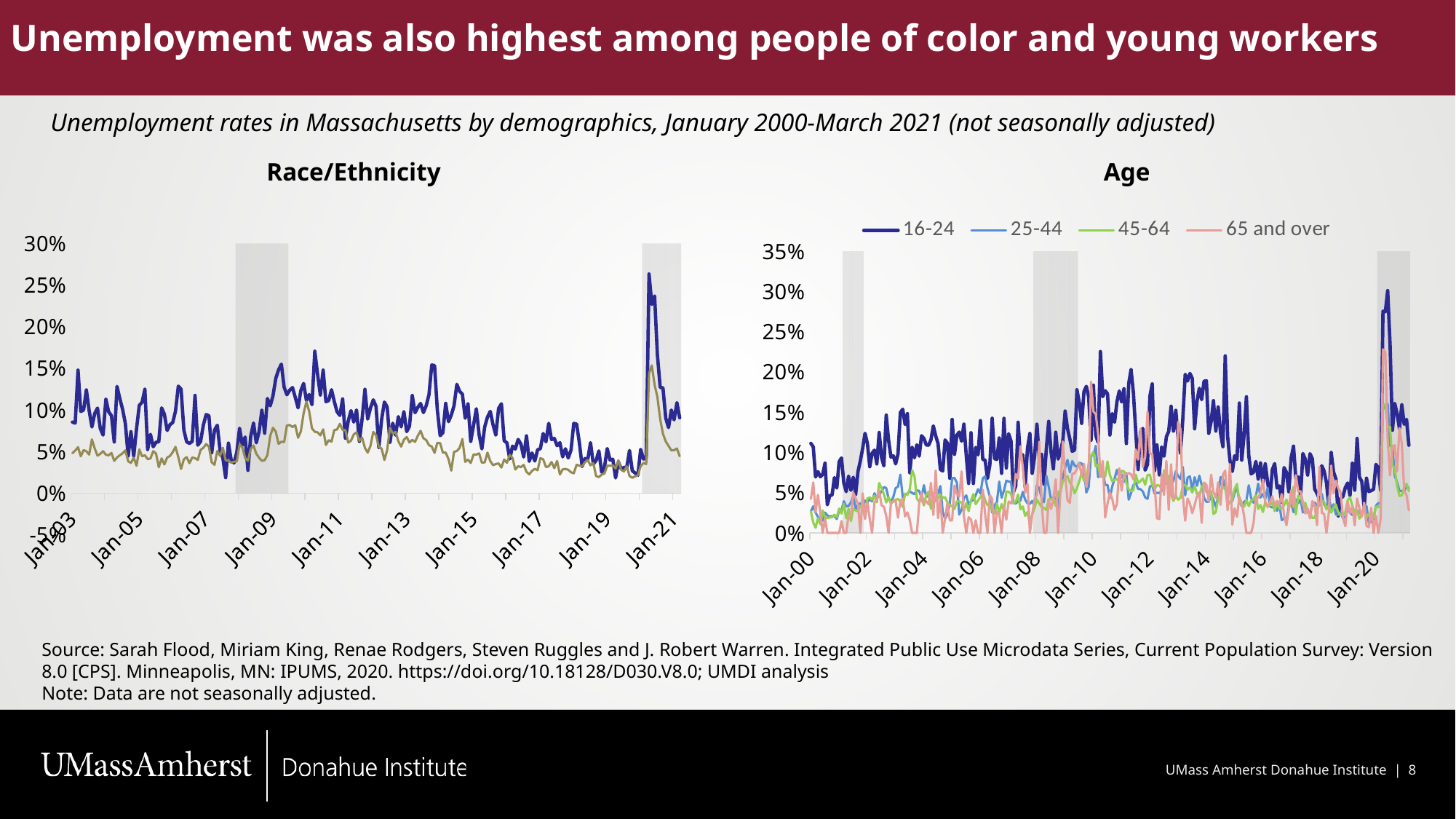
What kind of chart is the Age chart? Line chart How many series does the legend of the Age chart list? 4 In the Race/Ethnicity chart, which line is higher for most of the period, the dark blue line or the olive line? The dark blue line In the Age chart, is the peak value for the 16-24 series around 2020 greater or less than 25%? greater In the Race/Ethnicity chart, is the peak of the olive line around 2020 greater or less than 10%? greater In the Age chart, does the 16-24 series generally rise or fall between Jan-14 and Jan-18? Fall What are the legend entries of the Age chart? 16-24, 25-44, 45-64, 65 and over What is the highest value shown on the vertical axis of the Age chart? 35% What kind of chart is the Race/Ethnicity chart? Line chart In the Race/Ethnicity chart, is the peak of the dark blue line around 2020 greater or less than 20%? greater In the Age chart, which age group has the highest unemployment rate across most of the period? 16-24